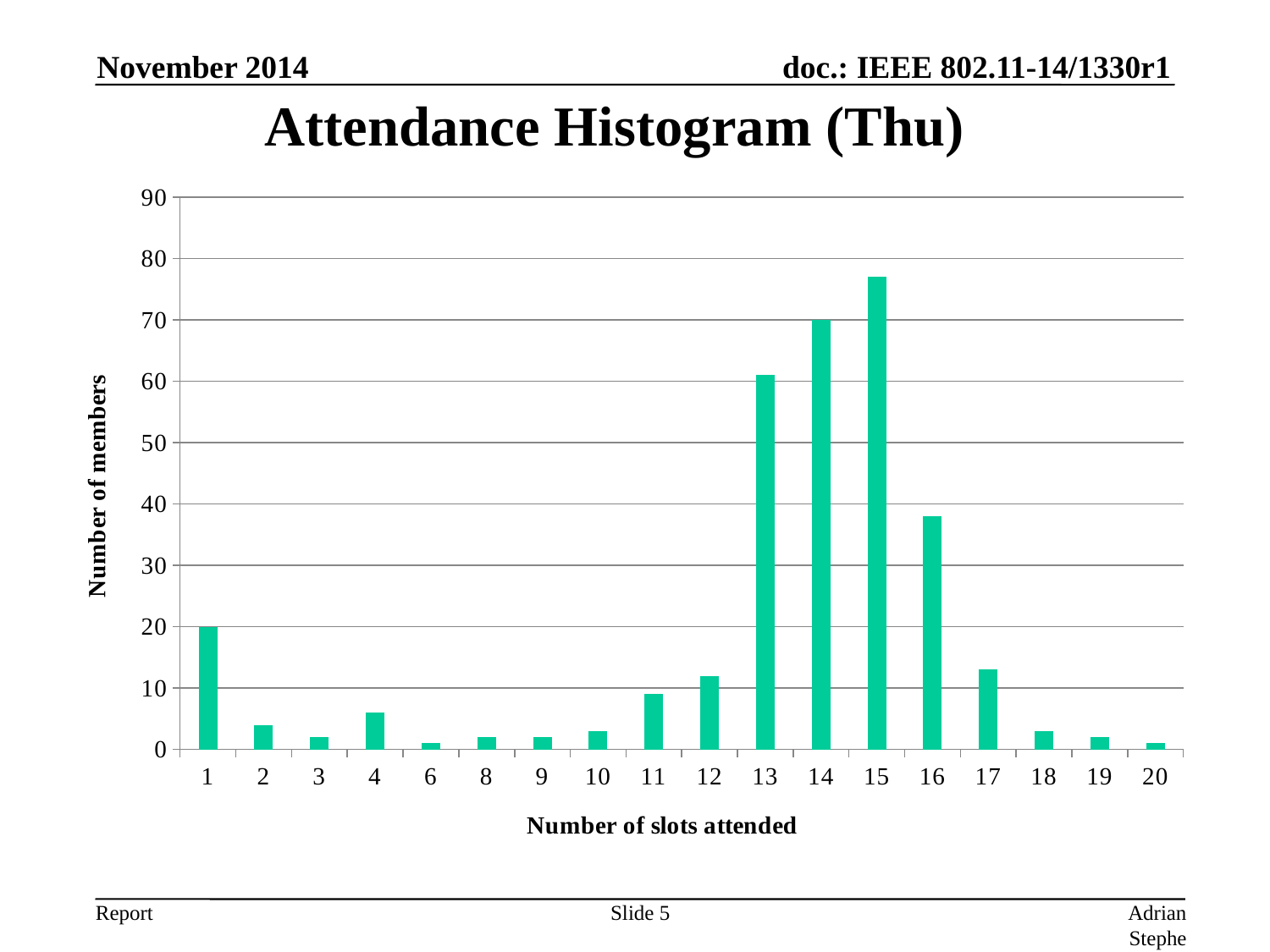
Is the value for 13 slots attended greater or less than 50? greater How many categories (numbers of slots attended) are shown on the x axis? 18 What is the number of members for 1 slot attended? 20 Is the value for 15 slots attended greater or less than 70? greater Is the value for 17 slots attended greater or less than 10? greater Which number of slots attended has the highest number of members? 15 Which has more members: 14 slots attended or 16 slots attended? 14 What is the title of the chart? Attendance Histogram (Thu) What is the label of the vertical axis? Number of members What is the number of members for 14 slots attended? 70 What kind of chart is shown on the slide? bar chart